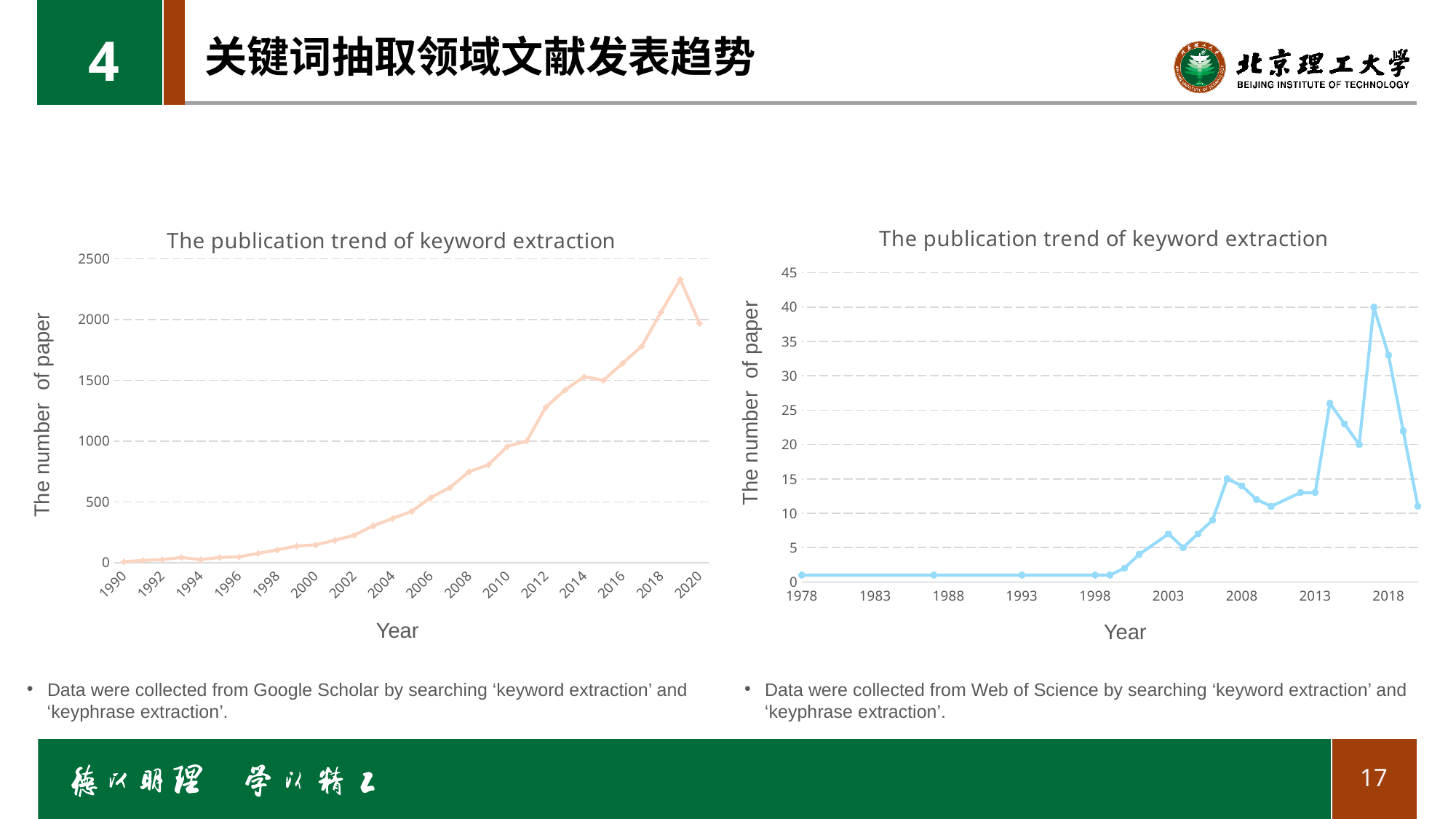
In the left chart (Google Scholar data), is the value for 2012 greater or less than 1000? greater In the right chart (Web of Science data), is the value for 2017 greater or less than 35? greater What kind of chart is the left chart, titled 'The publication trend of keyword extraction' with data from Google Scholar? line chart In the left chart (Google Scholar data), is the value for 2019 greater or less than 2000? greater In the left chart (Google Scholar data), do the values generally rise or fall from 1990 to 2019? rise In the left chart (Google Scholar data), which year has the highest number of papers? 2019 In the right chart (Web of Science data), which year has the highest number of papers? 2017 What is the label on the vertical axis of the right chart (Web of Science data)? The number of paper In the left chart (Google Scholar data), which year has the larger value, 2014 or 2018? 2018 In the right chart (Web of Science data), which year has the larger value, 2013 or 2015? 2015